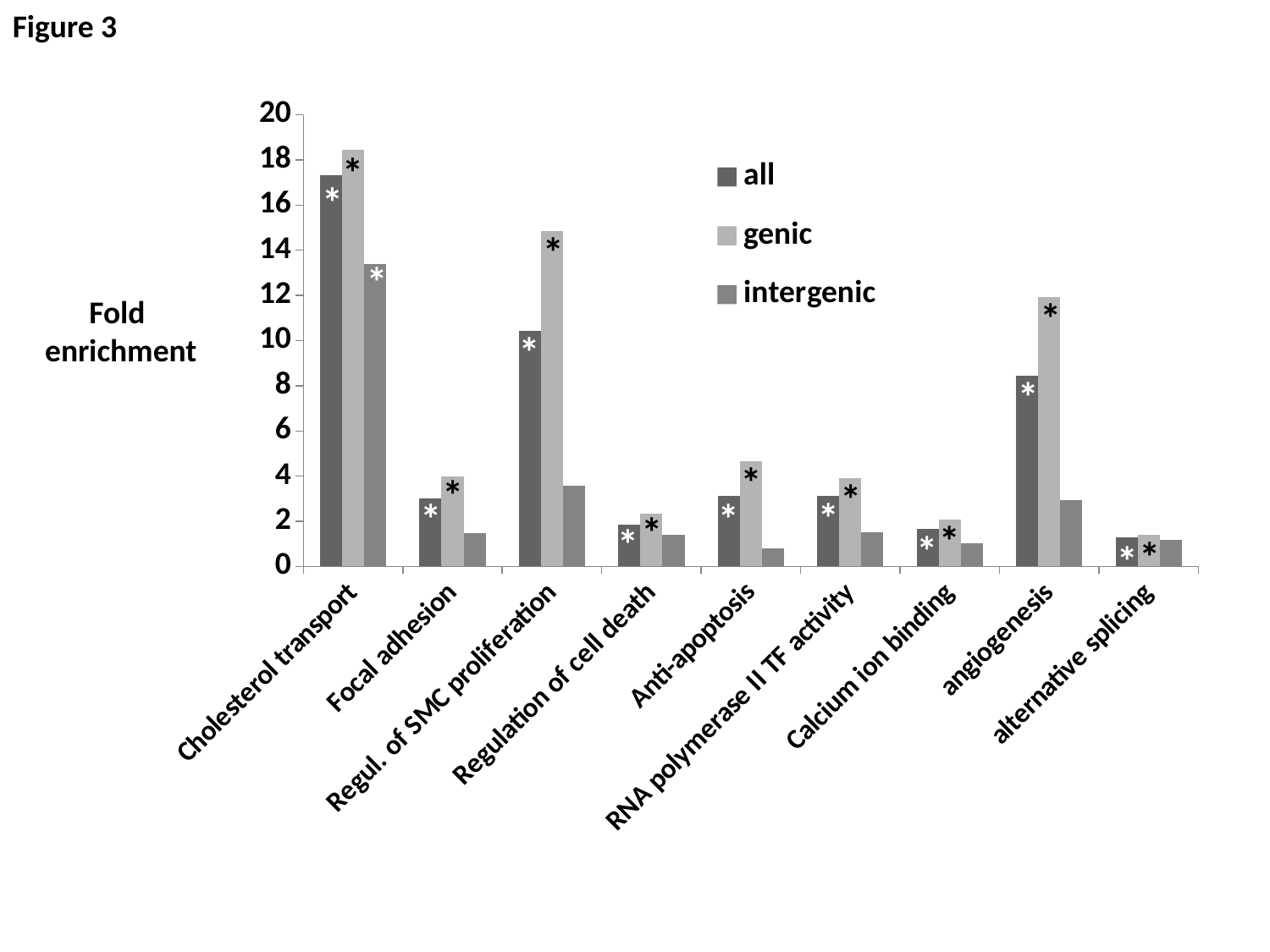
What is the label on the y axis? Fold enrichment Which category has the lowest value for the genic series? alternative splicing Which category has the highest value for the genic series? Cholesterol transport How many categories are shown on the x axis? 9 For Cholesterol transport, which is larger: the all series or the genic series? genic Is the intergenic value for Cholesterol transport greater or less than 12? greater Is the value for the all series for angiogenesis greater or less than 10? less What kind of chart is shown on the slide? bar chart How many series does the legend list? 3 Which category has the highest value for the intergenic series? Cholesterol transport For angiogenesis, which is larger: the genic series or the intergenic series? genic Is the genic value for Regul. of SMC proliferation greater or less than 14? greater